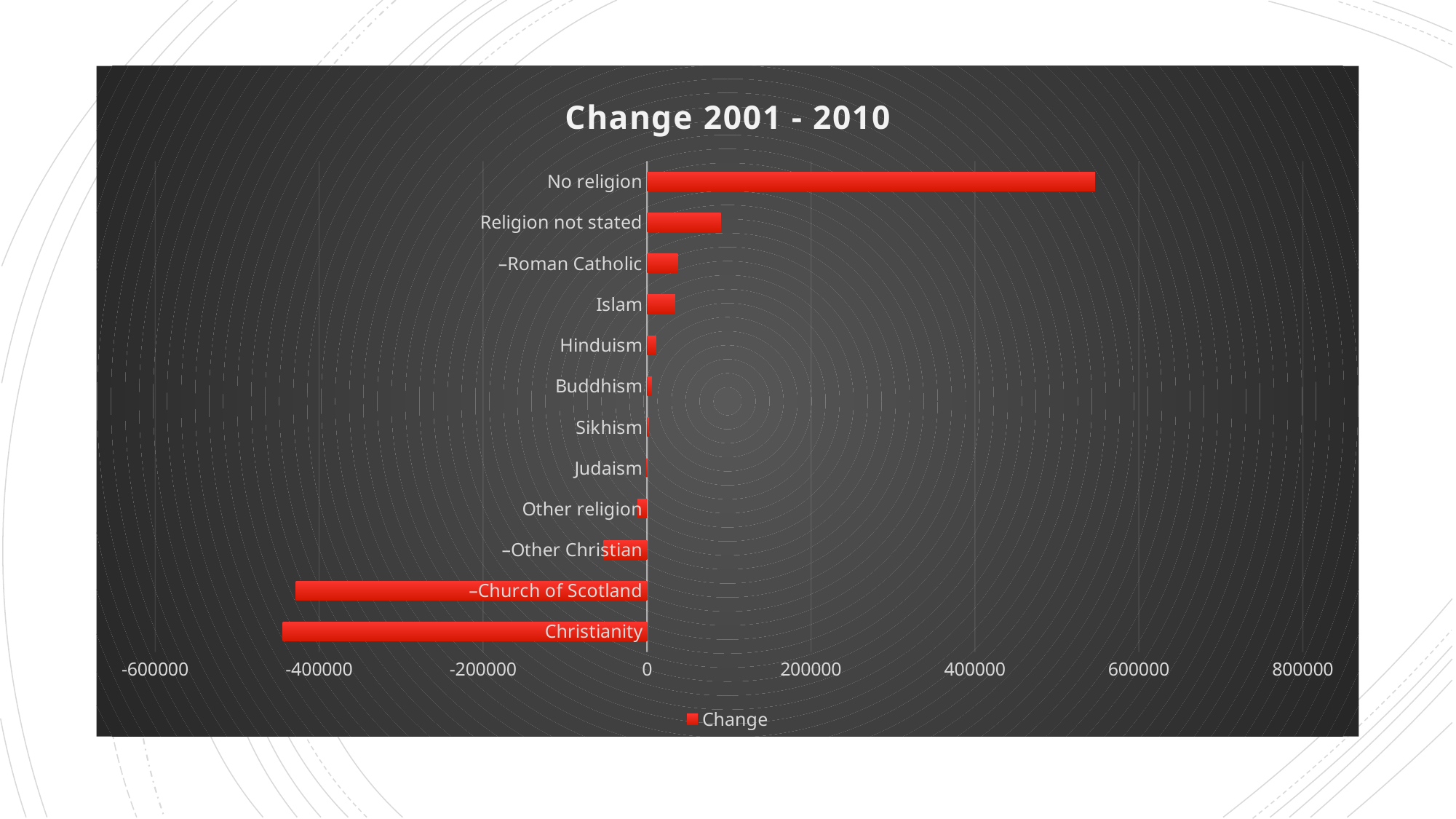
Which has the larger value, No religion or Religion not stated? No religion How many categories are plotted in the chart? 12 What type of chart is shown on the slide? Bar chart Is the value for Religion not stated greater or less than 200000? less Is the value for Christianity greater or less than -600000? greater How many series does the legend list? 1 Which has the larger value, Islam or Other Christian? Islam Is the value for No religion greater or less than 400000? greater What is the name of the series shown in the legend? Change Which category has the highest value in the chart? No religion What is the title of the chart? Change 2001 - 2010